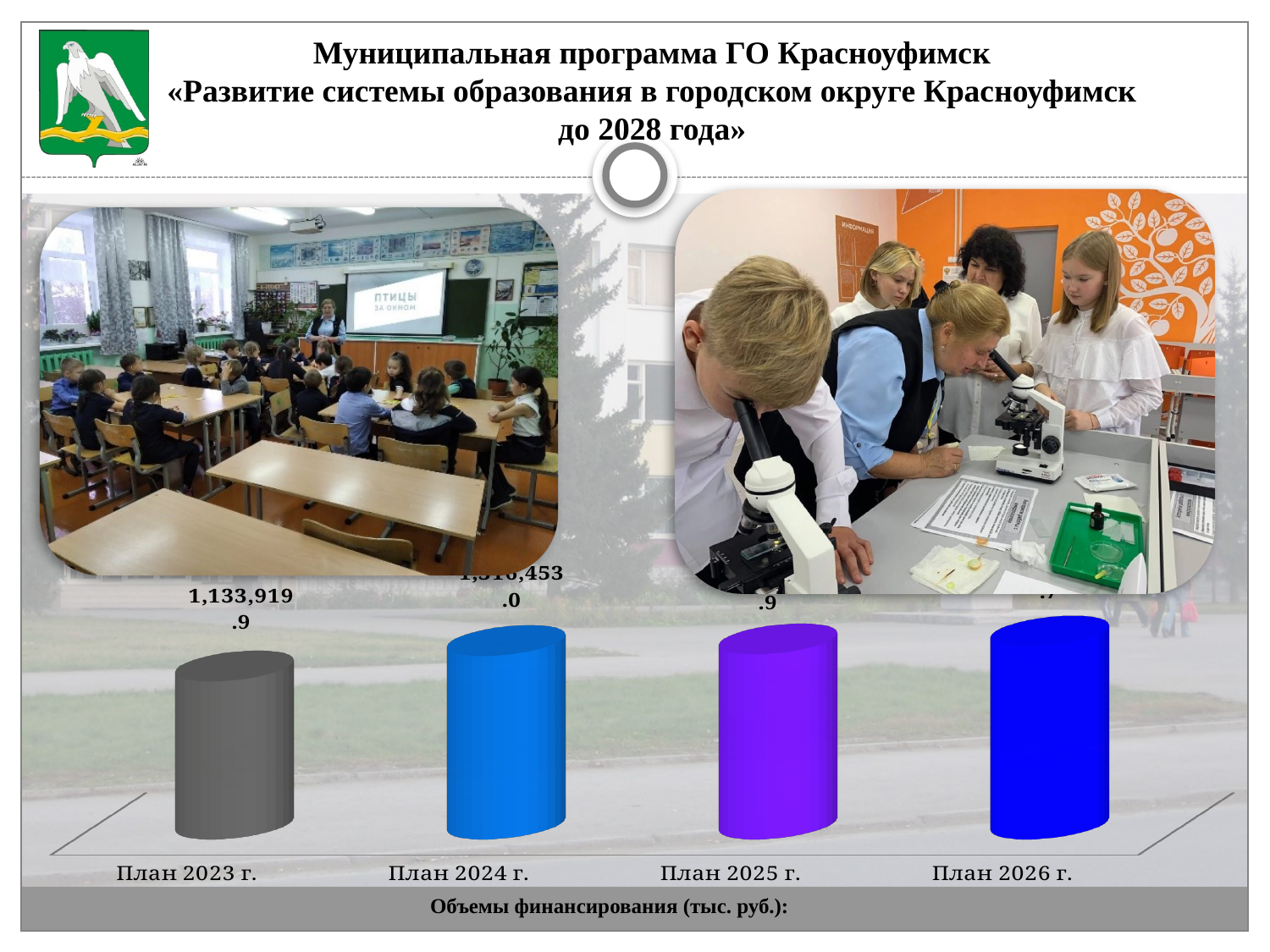
What unit of measurement is given in the caption below the chart? тыс. руб. What is the label of the first category on the x axis? План 2023 г. Which is larger, the value for План 2023 г. or the value for План 2026 г.? План 2026 г. How many categories are shown on the chart? 4 Which is larger, the value for План 2023 г. or the value for План 2024 г.? План 2024 г. What is the value shown for План 2023 г.? 1,133,919.9 Which category has the lowest value? План 2023 г. What kind of chart is shown on the slide? Bar chart